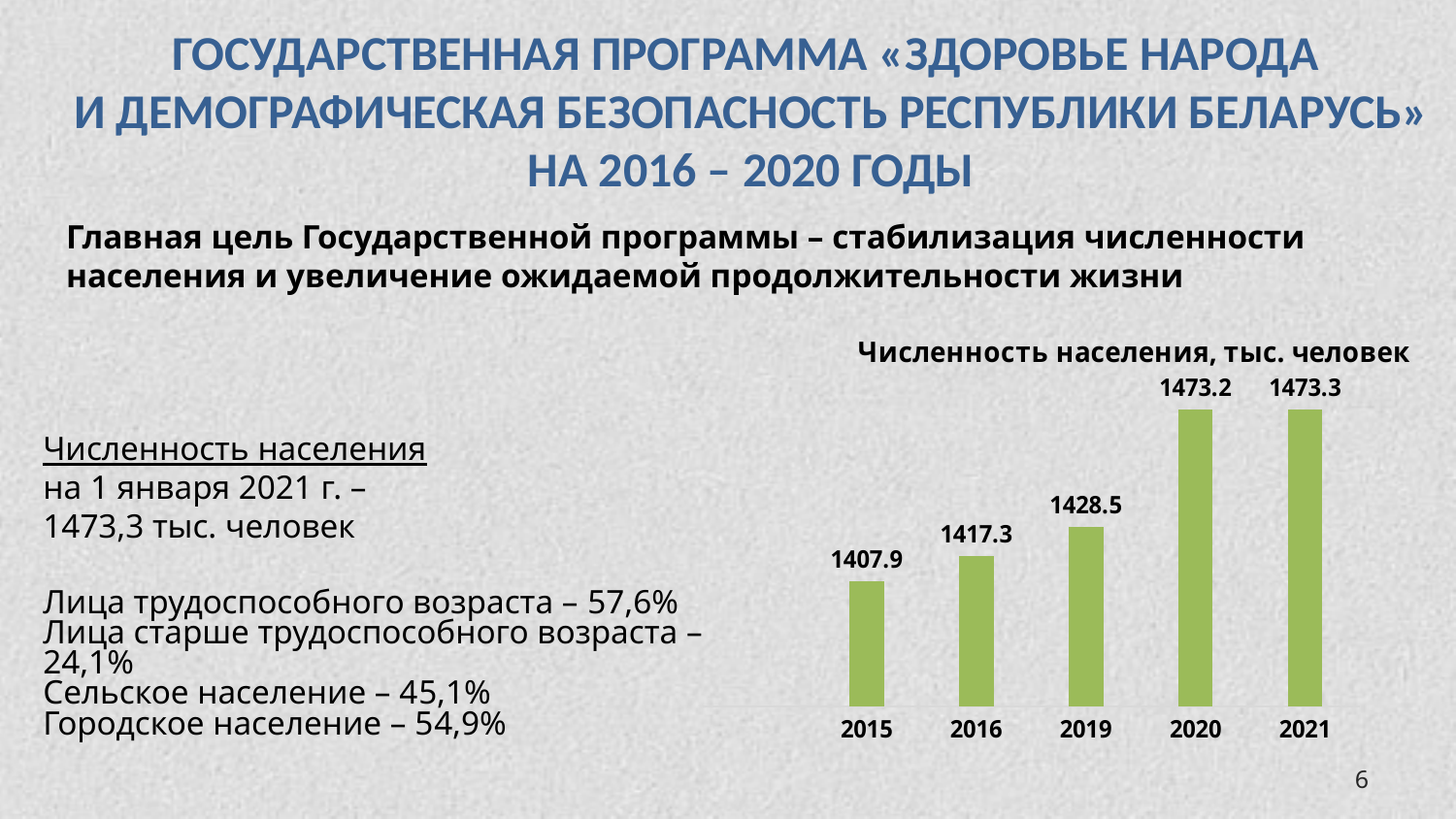
What is the population value shown for 2019 in the chart? 1428.5 Do the population values rise or fall from 2015 to 2021? rise What is the difference between the population values for 2020 and 2019? 44.7 What is the population value shown for 2016 in the chart? 1417.3 Which year has the lowest population value in the chart? 2015 What kind of chart is shown on the slide? bar chart Which year has the highest population value in the chart? 2021 Which is larger, the population value for 2019 or for 2016? 2019 How many years are shown on the x axis of the chart? 5 What is the population value shown for 2015 in the chart? 1407.9 What is the population value shown for 2021 in the chart? 1473.3 What is the difference between the population values for 2016 and 2015? 9.4